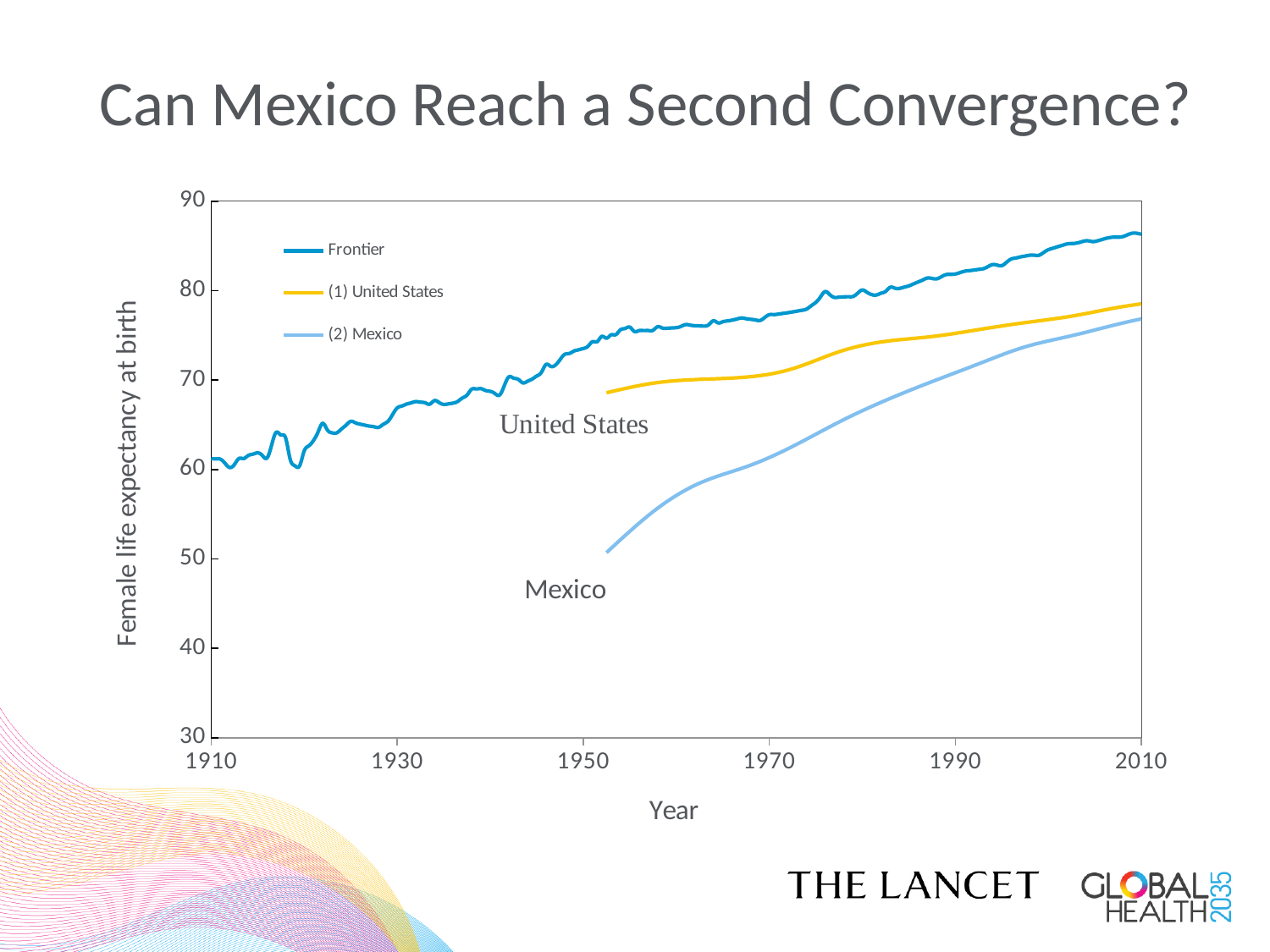
What is the label of the vertical axis? Female life expectancy at birth Is the value for the Frontier in 1930 greater or less than 60? greater What is the title of the slide? Can Mexico Reach a Second Convergence? In 1960, which is larger: the value for the United States or the value for Mexico? United States Is the value for Mexico in 1980 greater or less than 70? less How many series does the legend list? 3 Is the value for the Frontier in 2010 greater or less than 80? greater Does the Mexico line rise or fall from 1950 to 2010? Rise Which series has the highest value in 2010? Frontier What kind of chart is shown on the slide? Line chart Which series has the lowest value in 1970? (2) Mexico